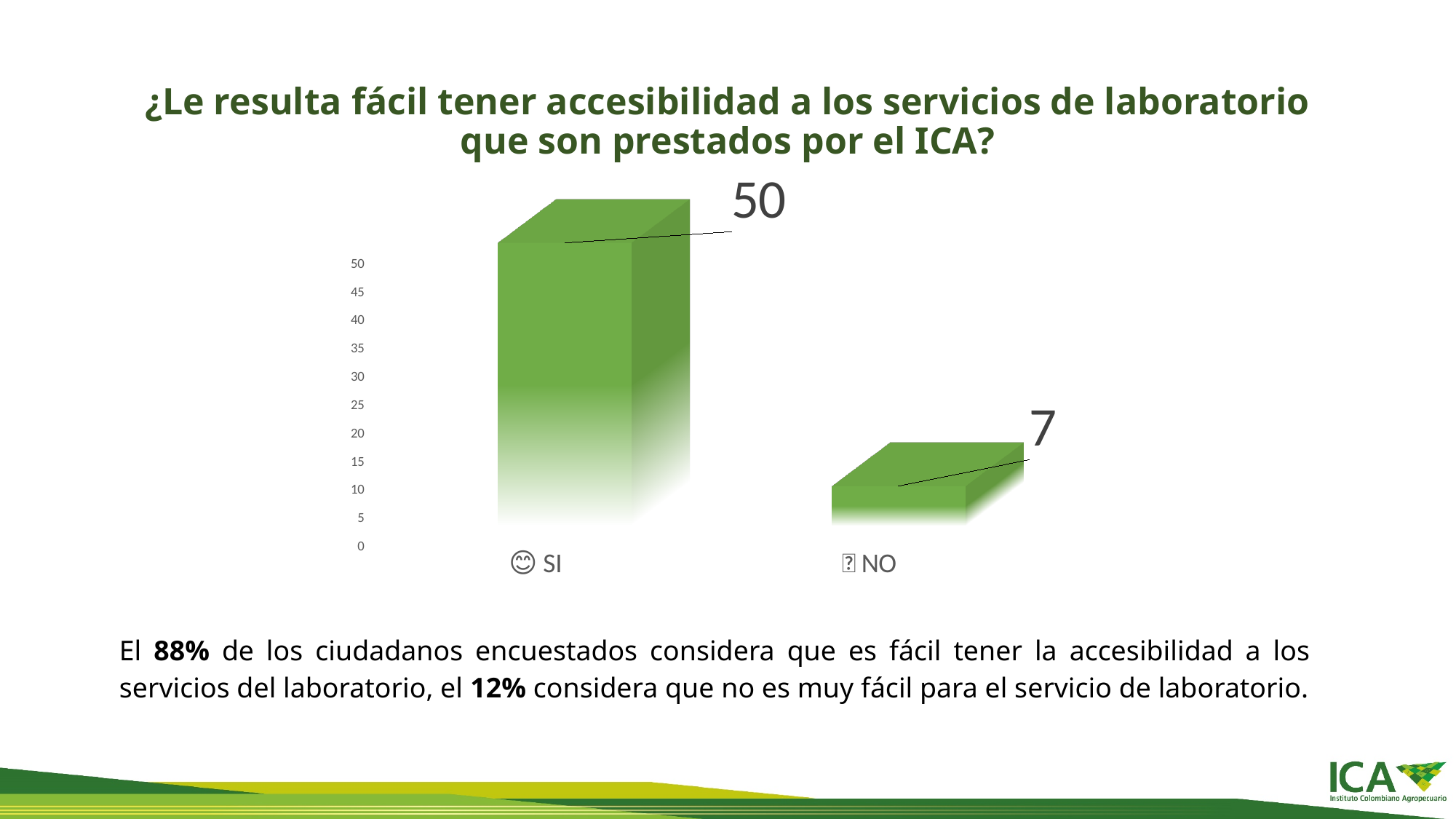
What is the value for SI? 50 How many categories are shown in the chart? 2 Is the value for NO greater or less than 10? less What is the value for NO? 7 Which is larger, the value for SI or the value for NO? SI Which category has the highest value? SI Which category has the lowest value? NO What kind of chart is shown on the slide? bar chart Is the value for SI greater or less than 45? greater What is the highest value shown on the vertical axis? 50 What is the total of the values for SI and NO? 57 What is the difference between the values for SI and NO? 43